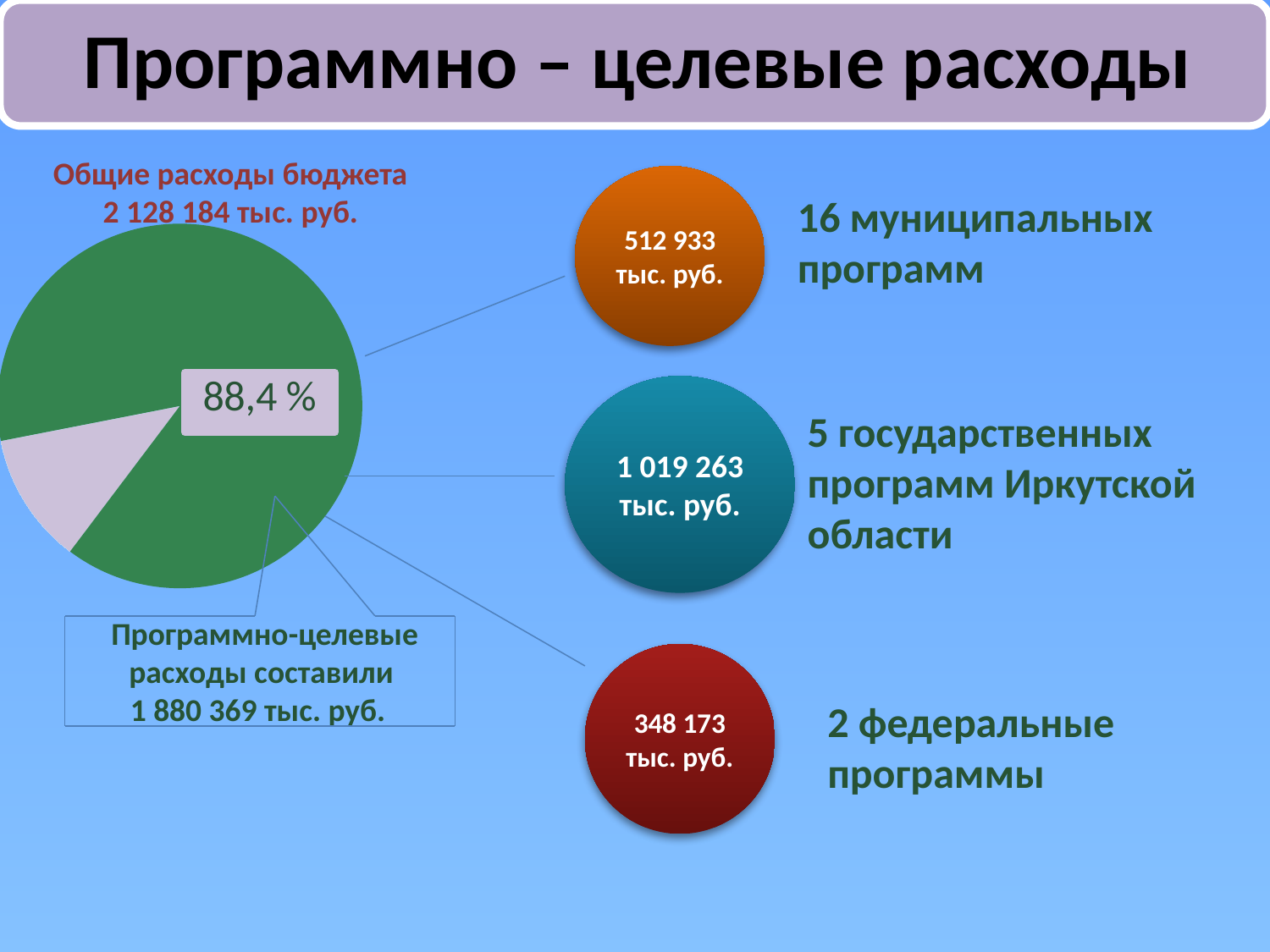
What share of the pie chart does the green slice (программно-целевые расходы) represent? 88,4 % What amount is shown in the red circle for the 2 federal programs? 348 173 тыс. руб. According to the slide, what were the total budget expenses (Общие расходы бюджета)? 2 128 184 тыс. руб. What is the difference between the total budget expenses and the program-targeted expenses, in тыс. руб.? 247 815 What amount is shown in the teal circle for the 5 state programs of Irkutsk region? 1 019 263 тыс. руб. What kind of chart is shown on the left of the slide? pie chart Which of the three program groups (municipal, state, federal) has the smallest amount? 2 федеральные программы What amount is shown in the orange circle for the 16 municipal programs? 512 933 тыс. руб. According to the slide, what did the program-targeted expenses (Программно-целевые расходы) amount to? 1 880 369 тыс. руб. Which slice of the pie chart is larger, the green one or the light purple one? the green one Which of the three program groups (municipal, state, federal) has the largest amount? 5 государственных программ Иркутской области How many slices does the pie chart have? 2